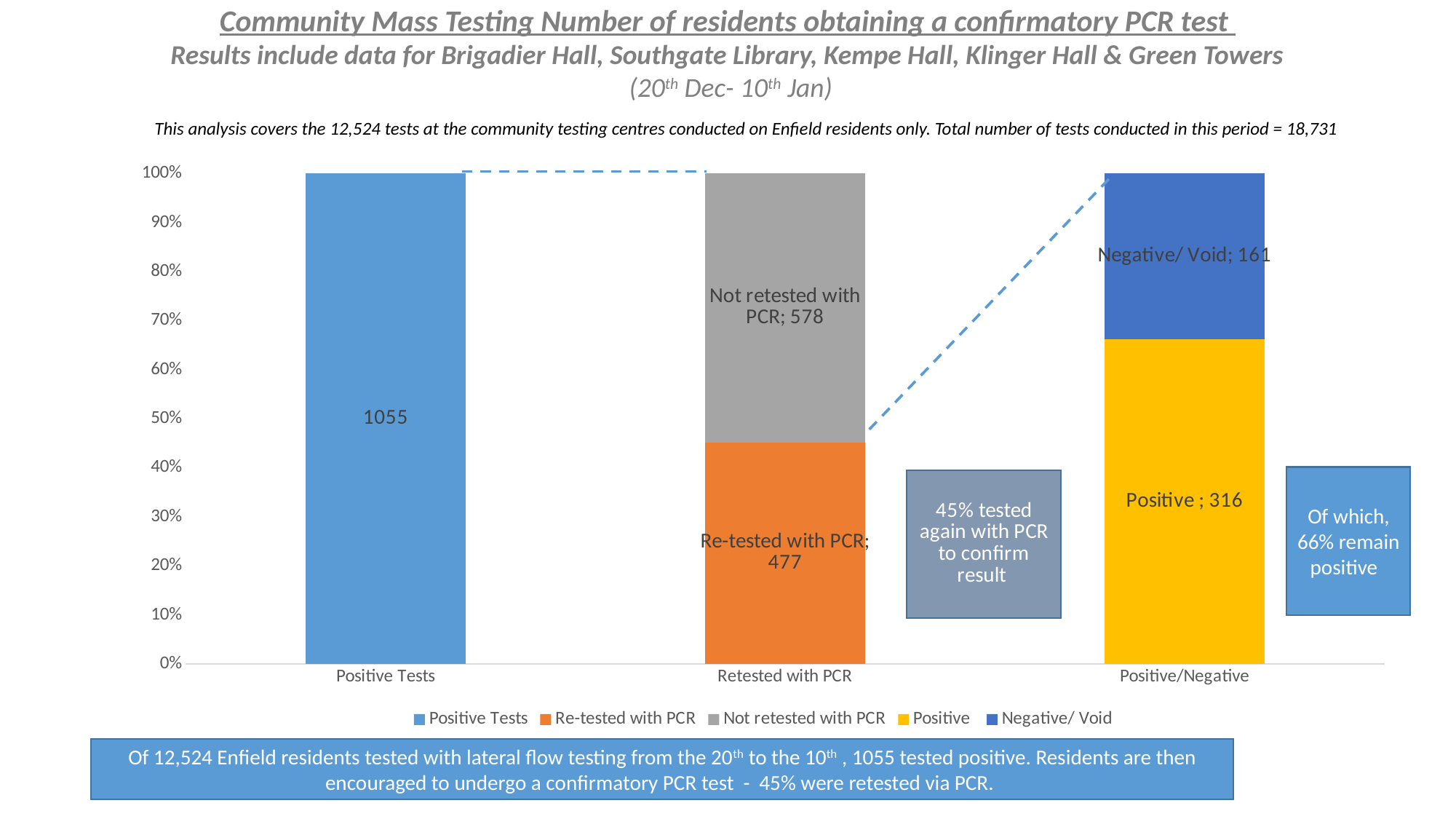
Which is larger, Re-tested with PCR or Not retested with PCR? Not retested with PCR What is the value for Not retested with PCR? 578 What is the value shown for the Positive Tests bar? 1055 What is the value of the Positive segment in the Positive/Negative bar? 316 What is the value of the Negative/ Void segment? 161 How many series does the legend list? 5 What is the difference between Not retested with PCR and Re-tested with PCR? 101 What is the total of the Retested with PCR stacked bar (477 + 578)? 1055 How many residents were Re-tested with PCR according to the data label? 477 How many categories are shown on the x axis? 3 What kind of chart is shown on the slide? Stacked bar chart What is the difference between the Positive and Negative/ Void values in the Positive/Negative bar? 155